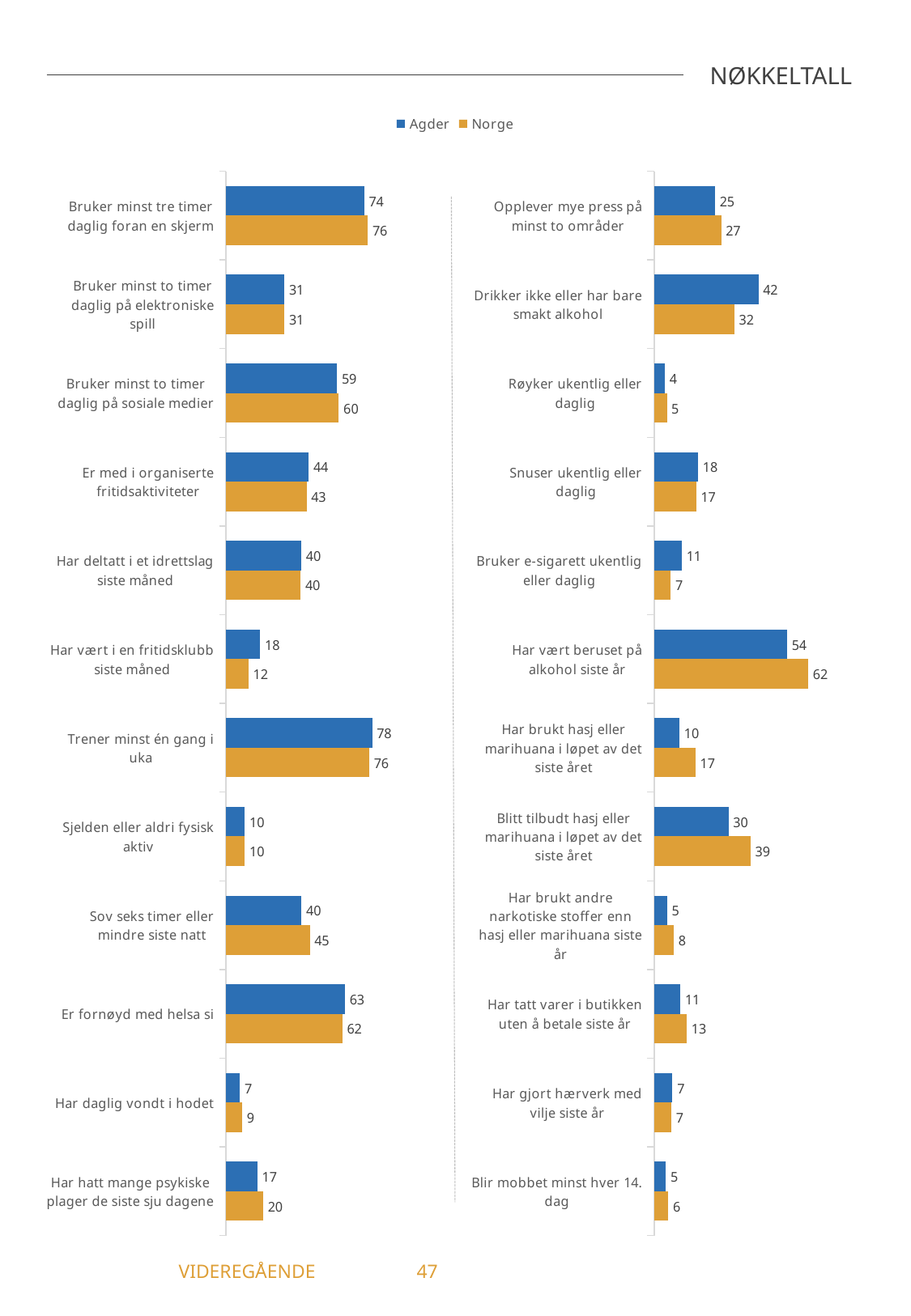
In the left chart, which category has the highest Norge value? Bruker minst tre timer daglig foran en skjerm and Trener minst én gang i uka (both 76) In the left chart, what is the difference between the Agder and Norge values for "Har vært i en fritidsklubb siste måned"? 6 How many categories does the left chart show? 12 In the right chart, which is larger for "Blitt tilbudt hasj eller marihuana i løpet av det siste året": Agder or Norge? Norge In the right chart, which category has the lowest Agder value? Røyker ukentlig eller daglig In the right chart, what is the difference between the Norge and Agder values for "Drikker ikke eller har bare smakt alkohol"? 10 How many series does the legend list? 2 In the left chart, which is larger for "Sov seks timer eller mindre siste natt": Agder or Norge? Norge Which colour represents Norge in the legend? Orange What kind of chart is shown on the slide? Bar chart In the left chart, what is the Agder value for "Trener minst én gang i uka"? 78 In the right chart, what is the Norge value for "Har vært beruset på alkohol siste år"? 62